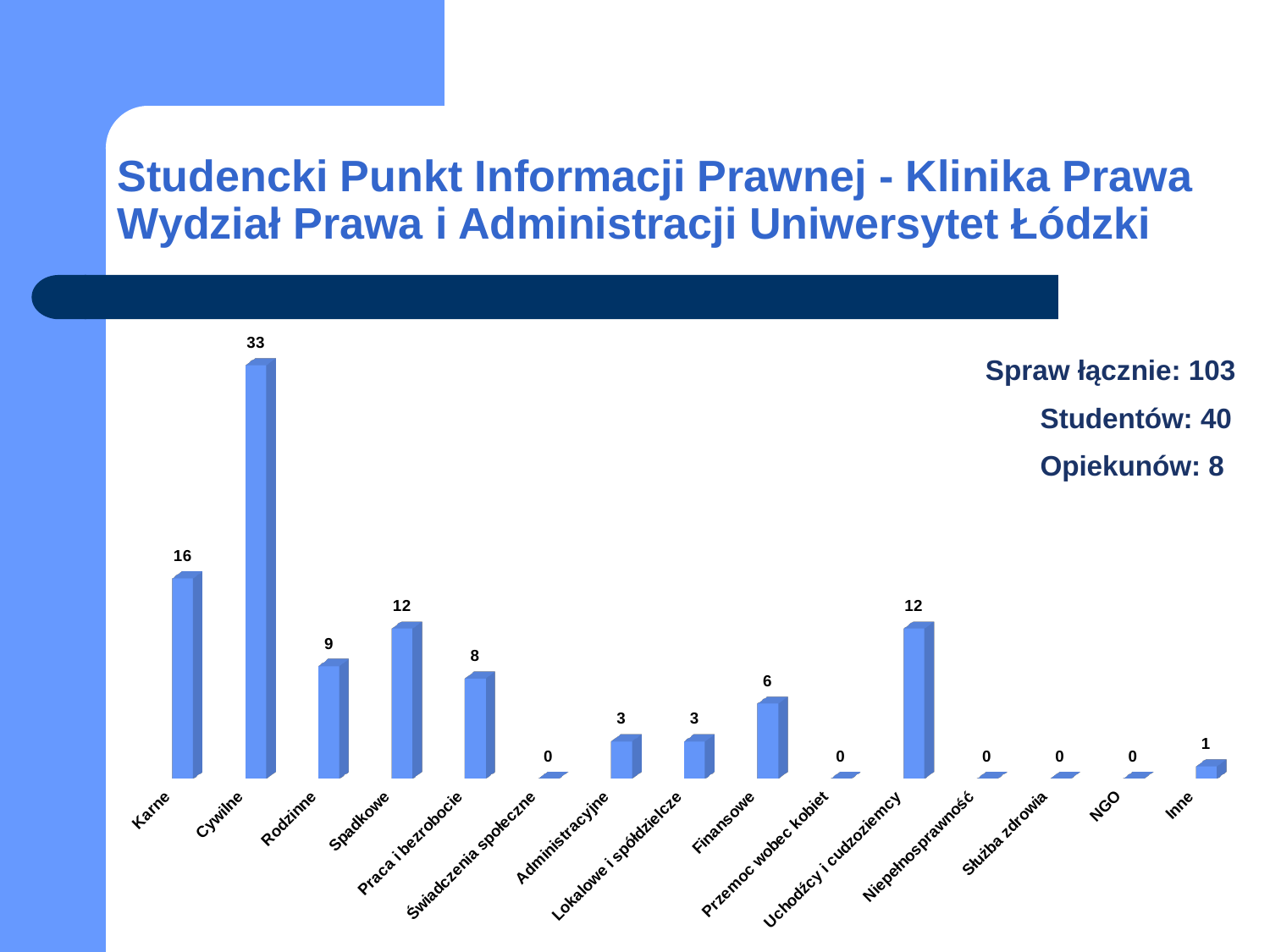
Which is larger, the value for Finansowe or the value for Administracyjne? Finansowe What kind of chart is shown on the slide? Bar chart What is the value for Praca i bezrobocie? 8 What is the difference between the values for Spadkowe and Rodzinne? 3 What is the value for Uchodźcy i cudzoziemcy? 12 Which category has the highest value? Cywilne What is the value for Karne? 16 What is the value for Cywilne? 33 What is the difference between the values for Cywilne and Karne? 17 How many categories are shown on the x axis? 15 What total number of cases (Spraw łącznie) is stated on the slide? 103 How many categories have a value of 0? 5